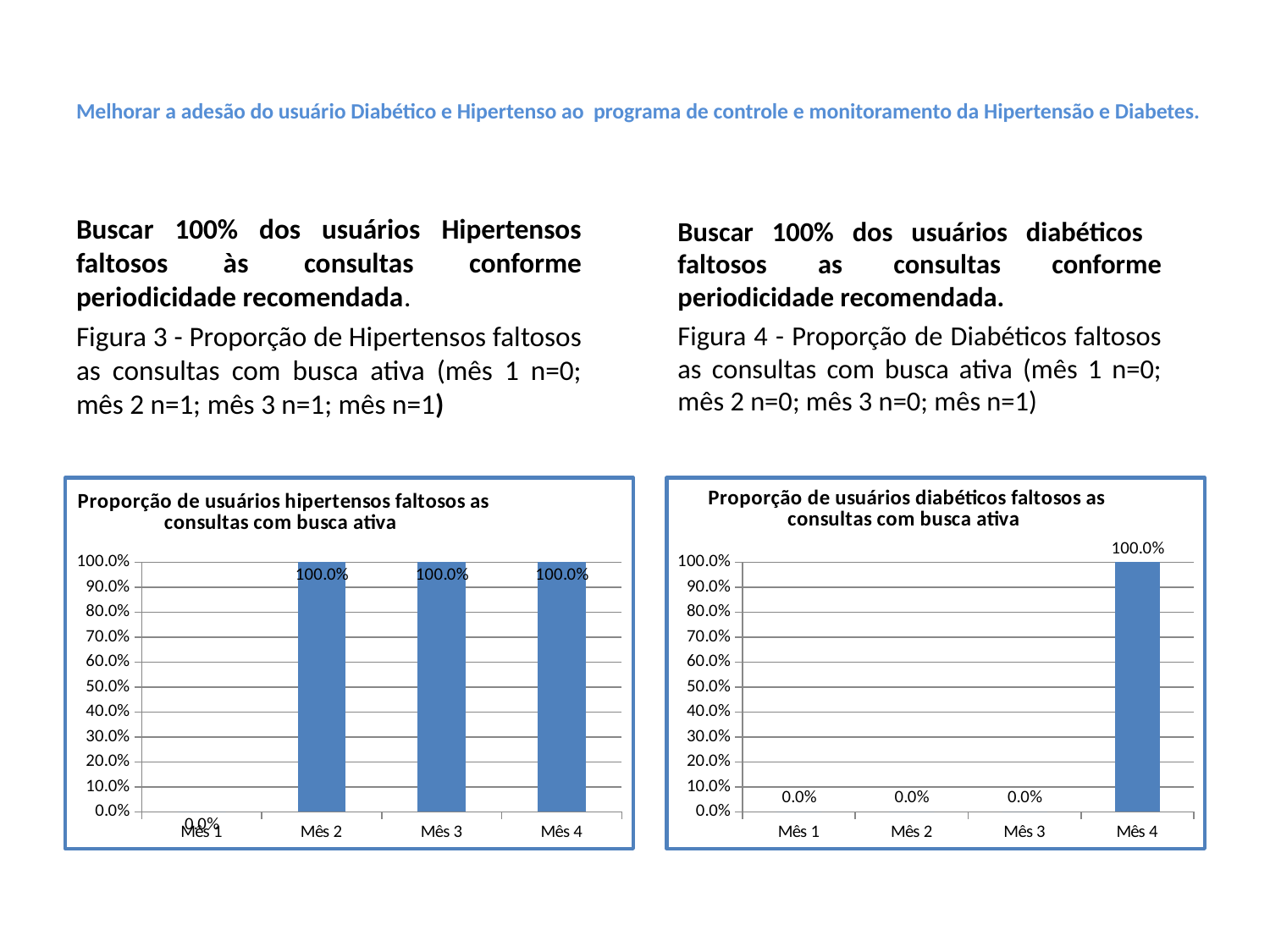
In the chart 'Proporção de usuários hipertensos faltosos as consultas com busca ativa', what is the value for Mês 2? 100.0% What kind of chart is 'Proporção de usuários diabéticos faltosos as consultas com busca ativa'? Bar chart In the chart 'Proporção de usuários diabéticos faltosos as consultas com busca ativa', which month has the highest value? Mês 4 In the chart 'Proporção de usuários hipertensos faltosos as consultas com busca ativa', what is the value for Mês 1? 0.0% How many months are shown on the x axis of the chart 'Proporção de usuários hipertensos faltosos as consultas com busca ativa'? 4 What is the title of the chart on the right side of the slide? Proporção de usuários diabéticos faltosos as consultas com busca ativa In the chart 'Proporção de usuários hipertensos faltosos as consultas com busca ativa', which month has the lowest value? Mês 1 In the chart 'Proporção de usuários hipertensos faltosos as consultas com busca ativa', what is the difference between the values for Mês 3 and Mês 1? 100.0% In the chart 'Proporção de usuários diabéticos faltosos as consultas com busca ativa', what is the value for Mês 4? 100.0% In the chart 'Proporção de usuários diabéticos faltosos as consultas com busca ativa', what is the value for Mês 3? 0.0% In the chart 'Proporção de usuários hipertensos faltosos as consultas com busca ativa', how many months have a value of 100.0%? 3 In the chart 'Proporção de usuários diabéticos faltosos as consultas com busca ativa', which is larger, the value for Mês 2 or Mês 4? Mês 4